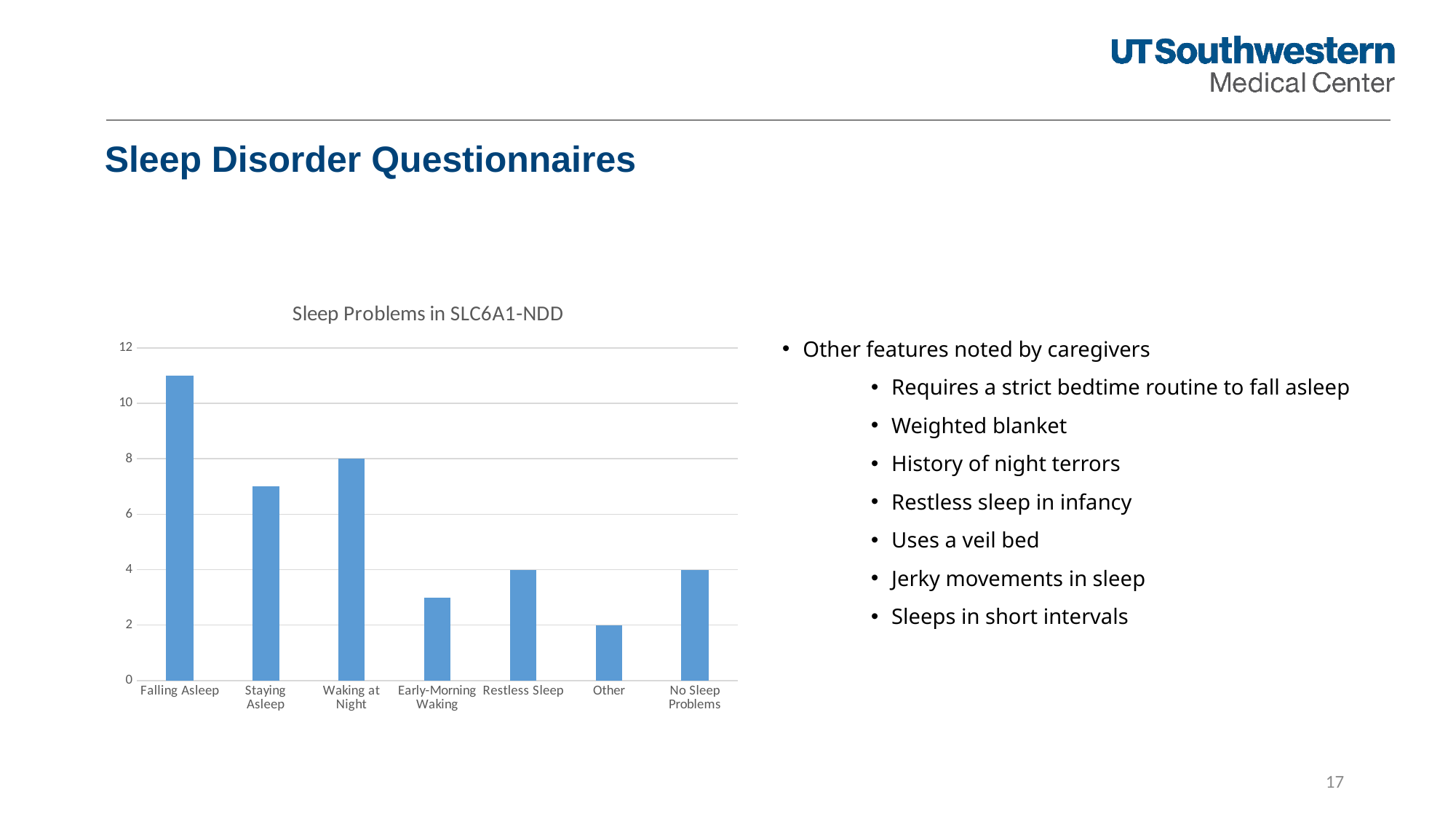
Is the value for Falling Asleep greater or less than 10? greater What is the value for No Sleep Problems? 4 What is the title of the chart? Sleep Problems in SLC6A1-NDD Which category has the highest value in the chart? Falling Asleep What kind of chart is shown on the slide? bar chart What is the value for Other? 2 What is the value for Waking at Night? 8 Which category has the lowest value in the chart? Other Which is larger, the value for Staying Asleep or the value for Waking at Night? Waking at Night What is the difference between the values for Waking at Night and Other? 6 How many categories are shown on the x axis of the chart? 7 Is the value for Early-Morning Waking greater or less than 4? less